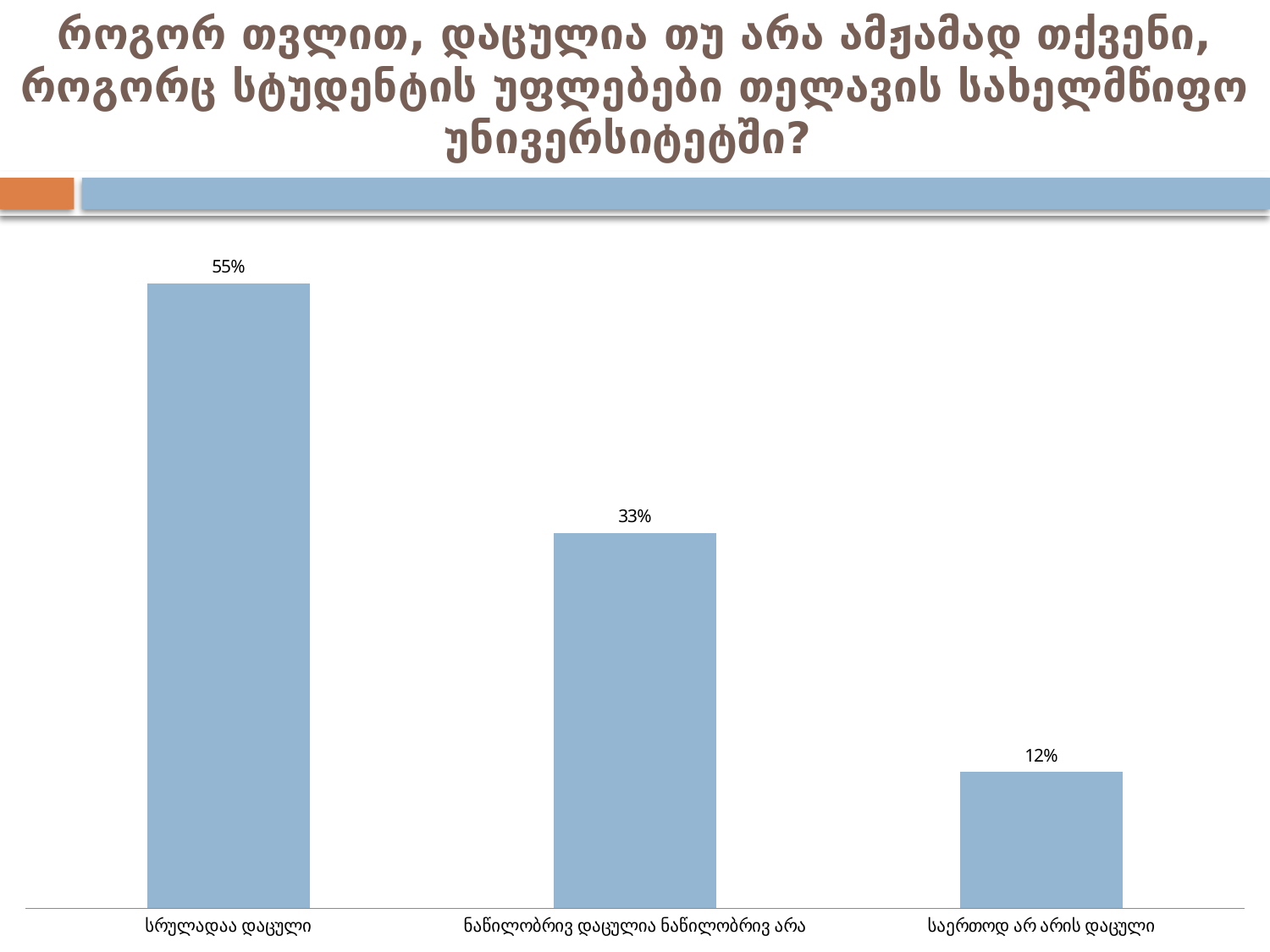
Which category has the highest value? სრულადაა დაცული What is the difference between the values for "ნაწილობრივ დაცულია ნაწილობრივ არა" and "საერთოდ არ არის დაცული"? 21% Do the values rise or fall from left to right across the categories? fall What is the value for "ნაწილობრივ დაცულია ნაწილობრივ არა"? 33% Which is larger: the value for "ნაწილობრივ დაცულია ნაწილობრივ არა" or the value for "საერთოდ არ არის დაცული"? ნაწილობრივ დაცულია ნაწილობრივ არა What is the value for "სრულადაა დაცული"? 55% Which category has the lowest value? საერთოდ არ არის დაცული What colour are the bars in the chart? light blue What is the value for "საერთოდ არ არის დაცული"? 12% How many categories are shown in the chart? 3 What is the difference between the values for "სრულადაა დაცული" and "ნაწილობრივ დაცულია ნაწილობრივ არა"? 22% What type of chart is shown on the slide? bar chart